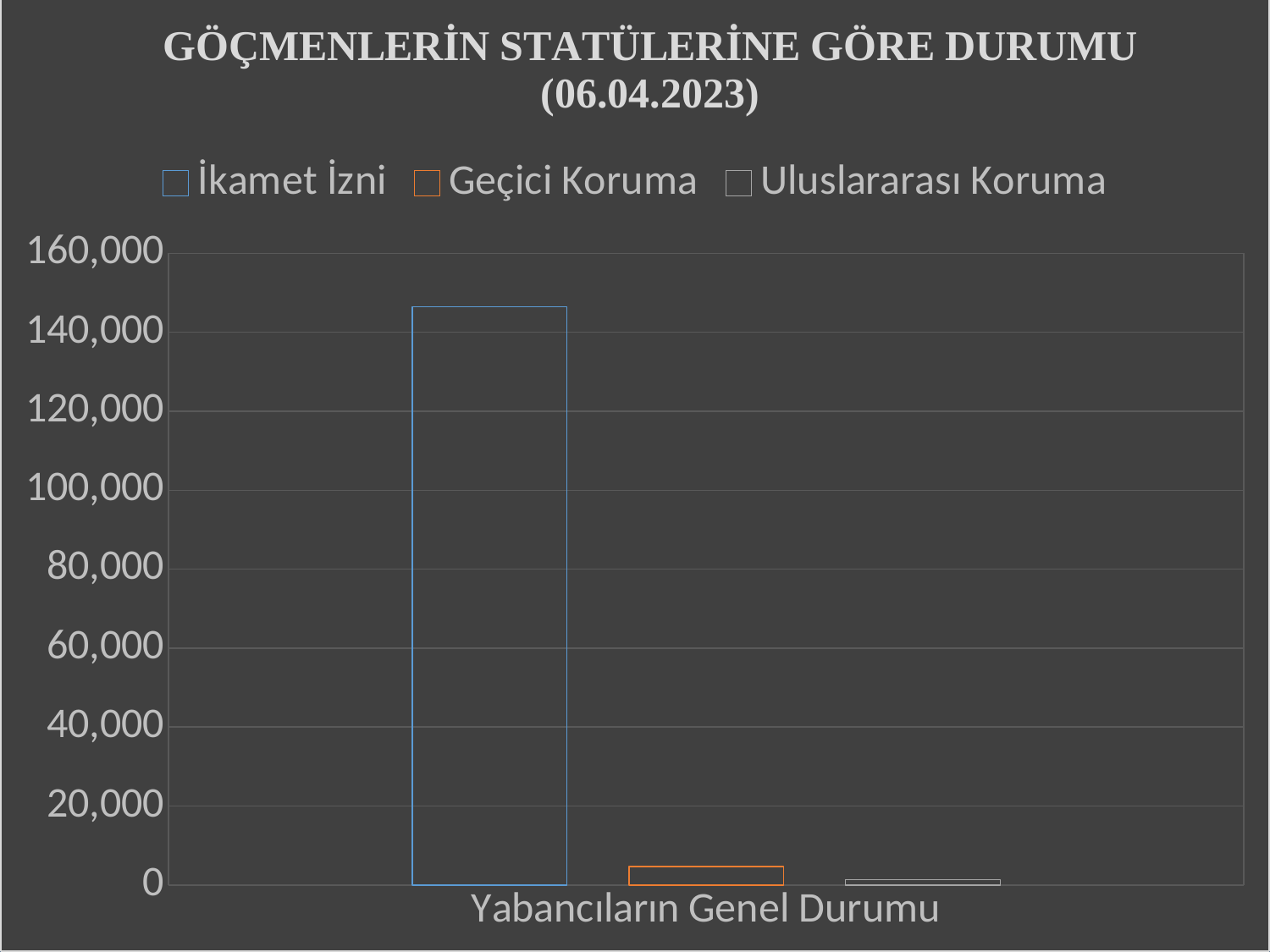
Which series has the lowest value for Yabancıların Genel Durumu? Uluslararası Koruma Which series has the highest value for Yabancıların Genel Durumu? İkamet İzni Which is larger, the value for Geçici Koruma or the value for Uluslararası Koruma? Geçici Koruma Is the value for İkamet İzni greater or less than 140,000? greater Is the value for Geçici Koruma greater or less than 20,000? less What is the title of the chart? GÖÇMENLERİN STATÜLERİNE GÖRE DURUMU (06.04.2023) How many categories are shown on the x axis? 1 How many series does the legend list? 3 Is the value for İkamet İzni greater or less than 160,000? less What kind of chart is shown on the slide? bar chart Which is larger, the value for İkamet İzni or the value for Geçici Koruma? İkamet İzni What is the label of the category on the x axis? Yabancıların Genel Durumu